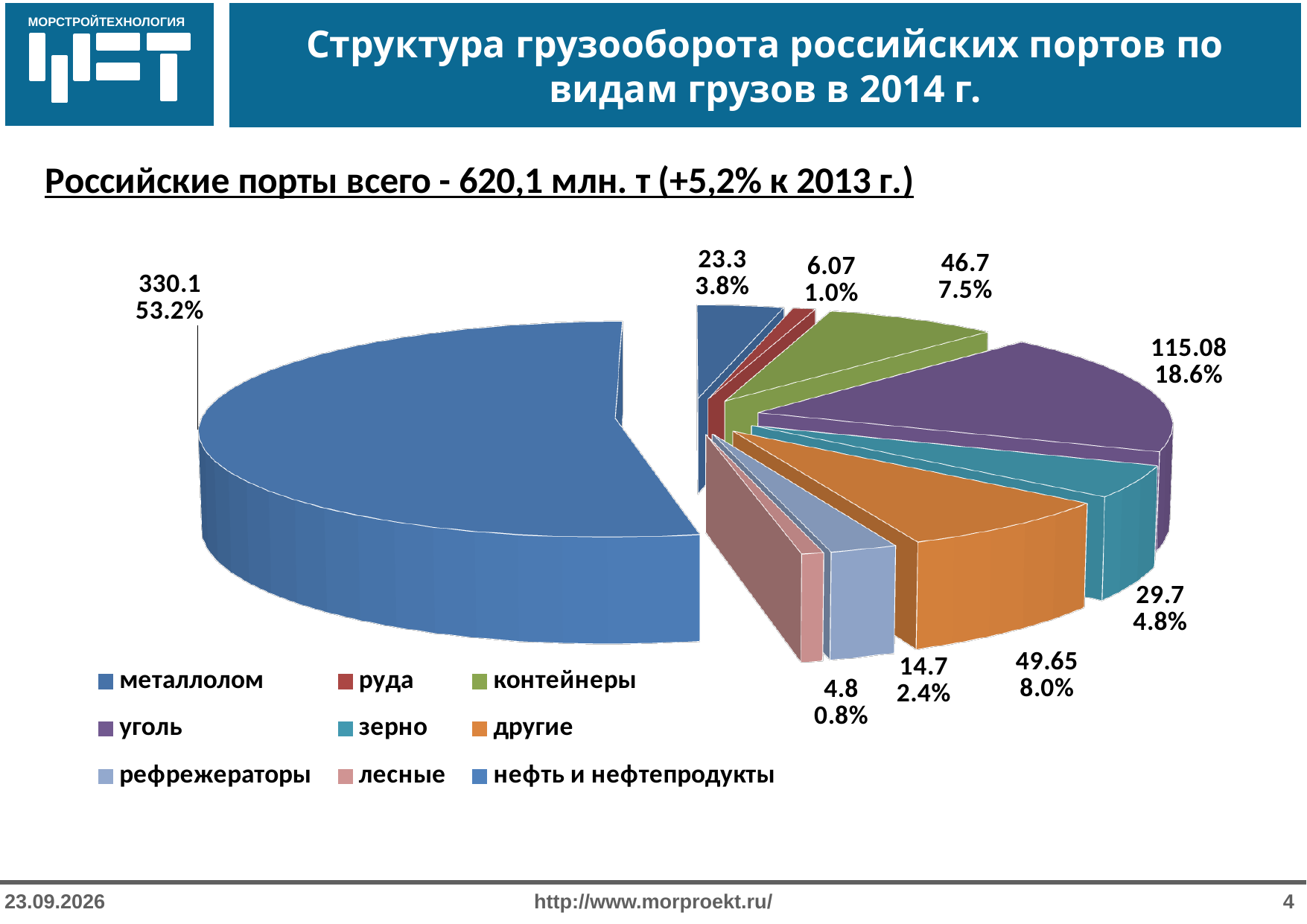
What total cargo turnover for Russian ports is stated above the chart? 620,1 млн. т What share of the pie does руда have? 1.0% What kind of chart is shown on the slide? pie chart What value is shown for рефрежераторы? 14.7 How many categories does the pie chart show? 9 Which category has the smallest slice of the pie? лесные What share of the pie does уголь have? 18.6% Which is larger, the value for зерно or the value for другие? другие Which category has the largest slice of the pie? нефть и нефтепродукты What value is shown for контейнеры? 46.7 What is the difference between the values for уголь and контейнеры? 68.38 What value is shown for нефть и нефтепродукты? 330.1